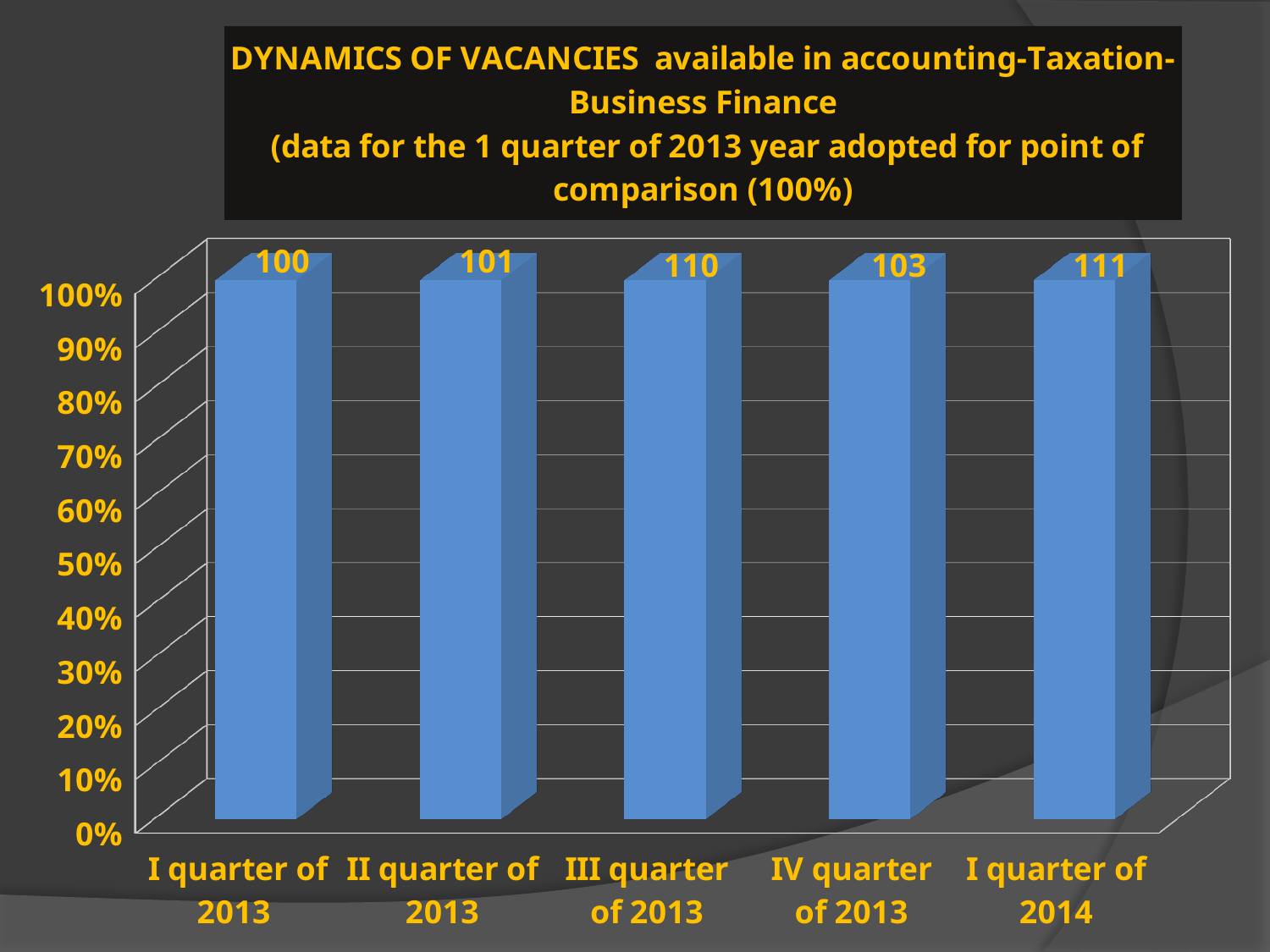
What kind of chart is shown on the slide? bar chart What is the value shown for IV quarter of 2013? 103 Which quarter is used as the point of comparison (100%) according to the chart title? 1 quarter of 2013 Which is larger, the value for III quarter of 2013 or the value for IV quarter of 2013? III quarter of 2013 How many quarters are shown on the chart? 5 Which quarter has the lowest value? I quarter of 2013 What is the difference between the values for III quarter of 2013 and IV quarter of 2013? 7 What is the value shown for II quarter of 2013? 101 What is the value shown for I quarter of 2014? 111 What is the difference between the values for I quarter of 2014 and I quarter of 2013? 11 Which quarter has the highest value? I quarter of 2014 What is the value shown for III quarter of 2013? 110